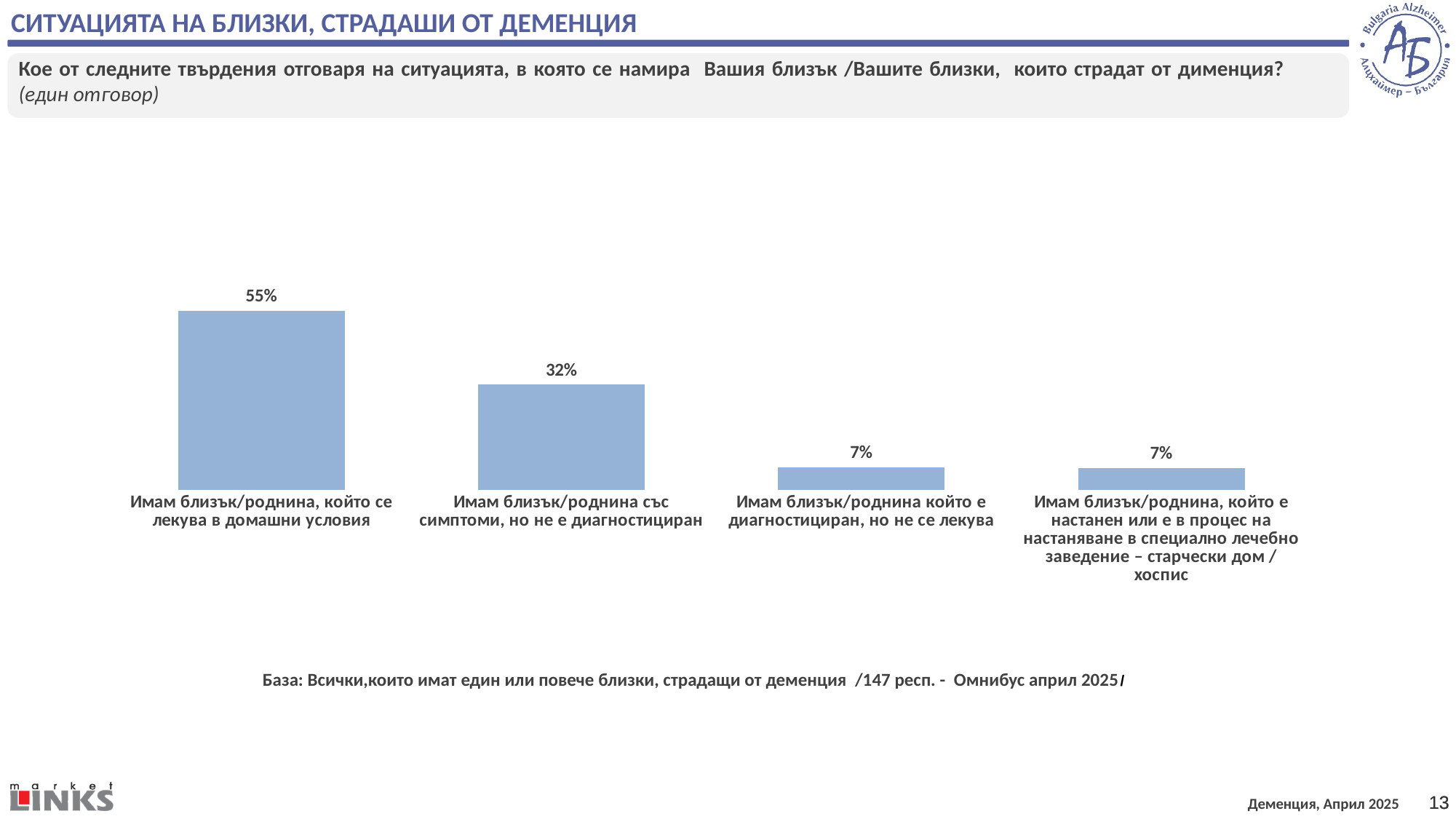
Which category has the highest value? Имам близък/роднина, който се лекува в домашни условия Do the values rise or fall from left to right across the categories? Fall What kind of chart is shown on the slide? Bar chart What is the value for "Имам близък/роднина който е диагностициран, но не се лекува"? 7% What is the value for the category about a relative placed in a specialised care facility (старчески дом / хоспис)? 7% Which is larger: the value for a relative treated at home or the value for a relative with symptoms but not diagnosed? Имам близък/роднина, който се лекува в домашни условия What is the difference between the value for "Имам близък/роднина със симптоми, но не е диагностициран" and "Имам близък/роднина който е диагностициран, но не се лекува"? 25% What percentage of respondents have a relative who is treated at home ("Имам близък/роднина, който се лекува в домашни условия")? 55% What is the value for "Имам близък/роднина със симптоми, но не е диагностициран"? 32% What is the difference between the value for a relative treated at home and the value for a relative with symptoms but not diagnosed? 23% How many respondents form the base of the chart, according to the note below it? 147 How many categories are shown in the chart? 4